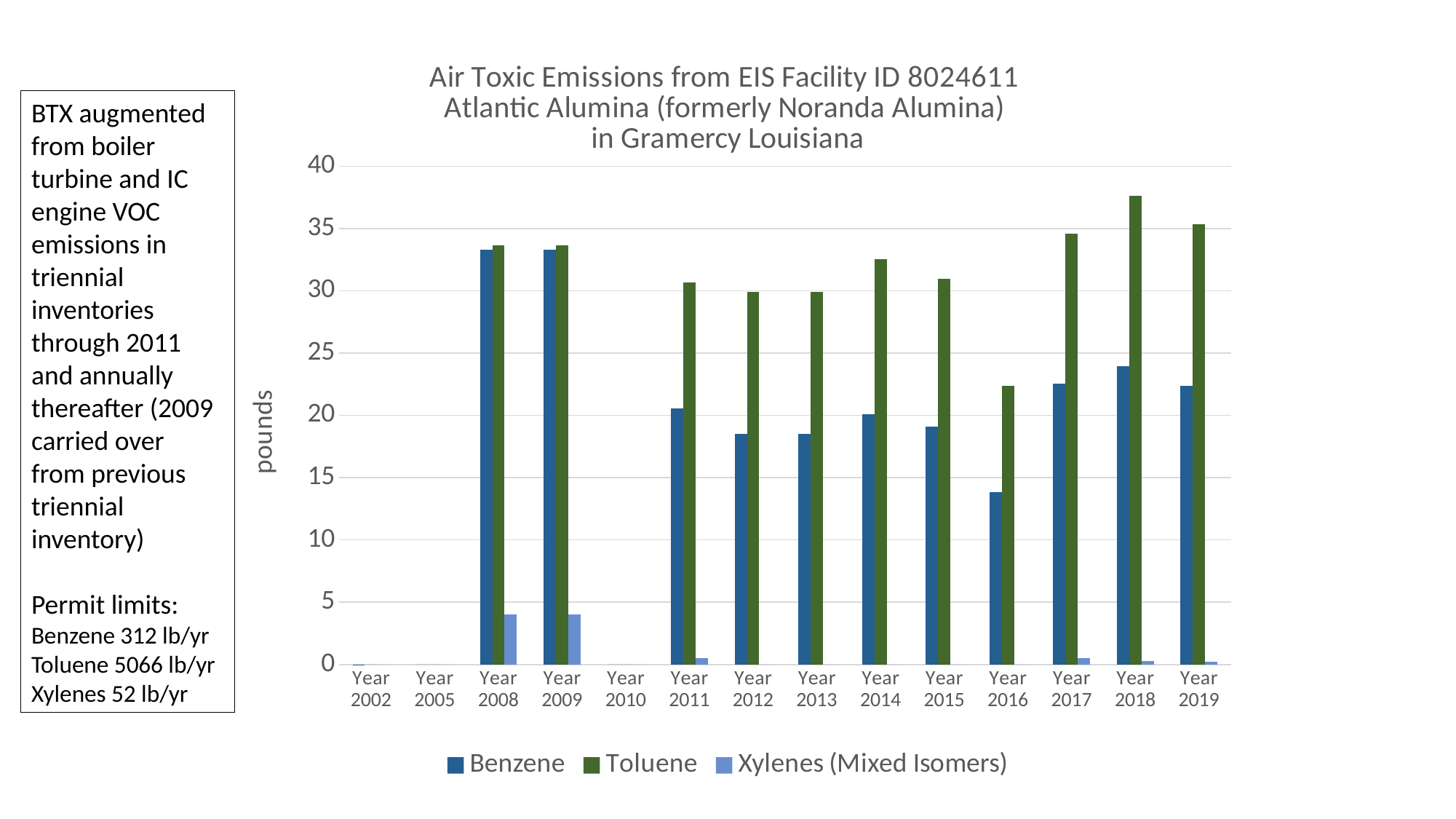
Is the Benzene value for Year 2016 greater or less than 15? less In Year 2017, which is larger, the Benzene value or the Toluene value? Toluene Is the Toluene value for Year 2014 greater or less than 30? greater Is the Xylenes (Mixed Isomers) value for Year 2008 greater or less than 5? less Which year has the highest Toluene bar? Year 2018 What kind of chart is shown on the slide? bar chart Do the Benzene values rise or fall from Year 2016 to Year 2018? rise How many year categories are shown on the x axis? 14 Among the years where a Toluene bar is shown, which year has the lowest Toluene value? Year 2016 How many series does the legend list? 3 What is the label on the y axis? pounds